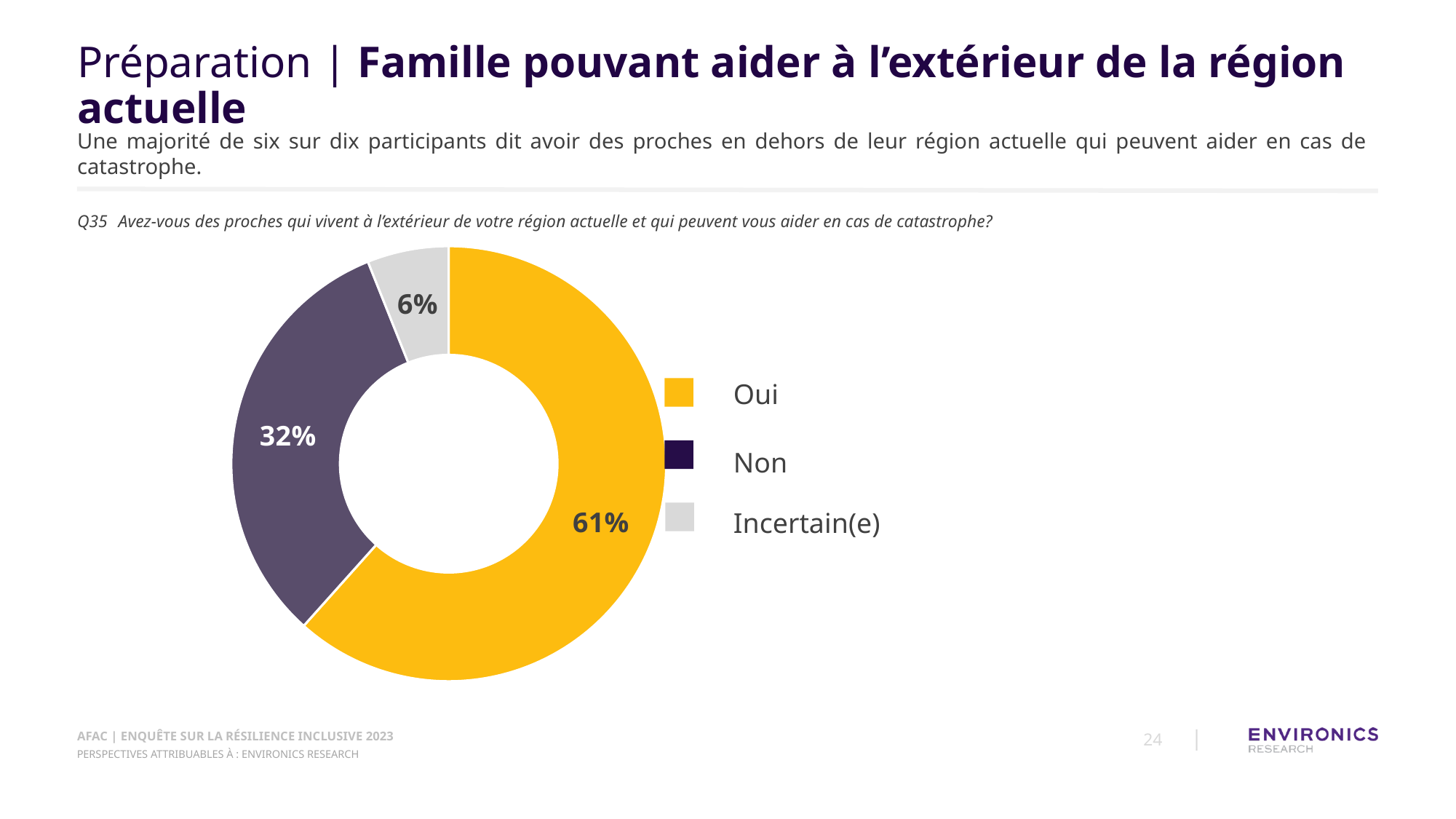
What kind of chart is shown on the slide? Pie chart (doughnut) Which is larger, the share for "Non" or the share for "Incertain(e)"? Non What colour represents the "Oui" response in the chart? Yellow What percentage of participants answered "Non"? 32% Which response has the largest share of the chart? Oui Which response has the smallest share of the chart? Incertain(e) Which survey question number does the chart report on? Q35 What is the difference in percentage points between "Non" and "Incertain(e)"? 26 What is the difference in percentage points between "Oui" and "Non"? 29 What percentage of participants answered "Incertain(e)"? 6% How many response categories are shown in the chart? 3 What percentage of participants answered "Oui"? 61%